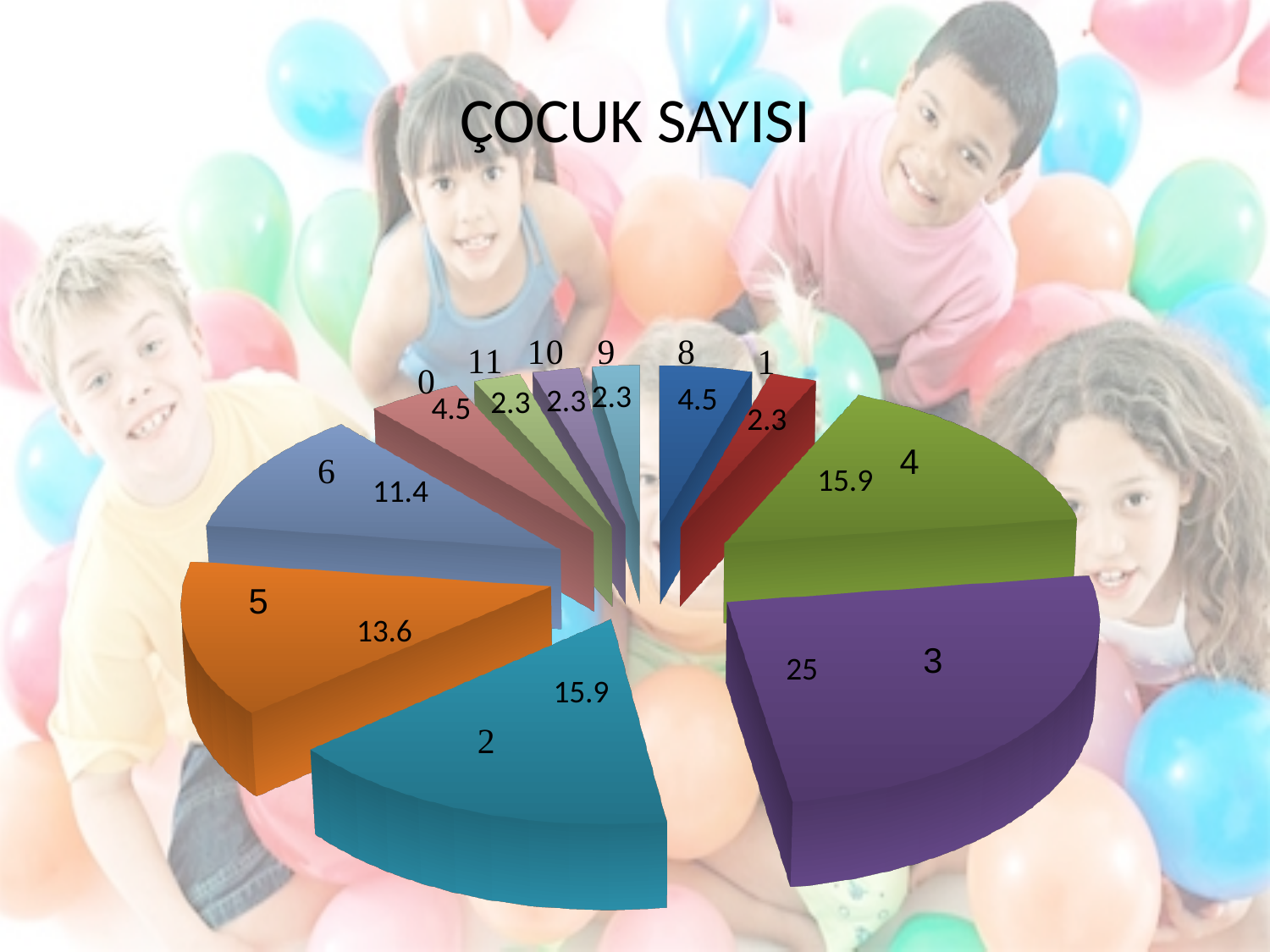
What is the value shown for category 6? 11.4 What is the value shown for category 5? 13.6 What kind of chart is shown on the slide? pie chart What is the difference between the values for category 3 and category 5? 11.4 What is the value shown for category 0? 4.5 What is the difference between the values for category 4 and category 1? 13.6 Which is larger, the value for category 6 or the value for category 8? category 6 What is the title of the chart? ÇOCUK SAYISI How many slices does the pie chart have? 11 What is the value shown for category 3? 25 What colour is the slice for category 2? teal Which category has the largest slice of the pie? 3